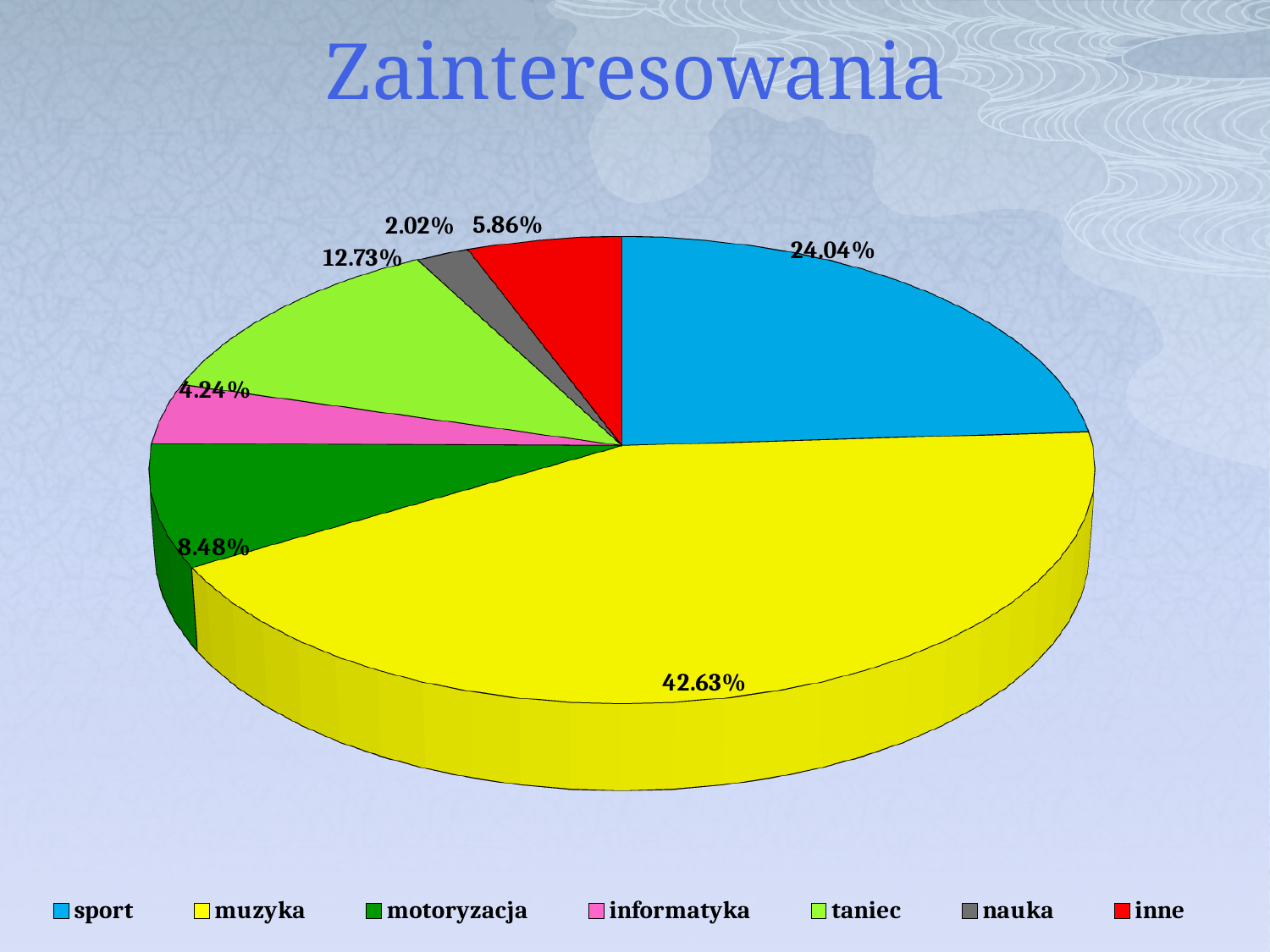
What is the title of the chart? Zainteresowania Which is larger, the share of motoryzacja or the share of informatyka? motoryzacja How many categories does the pie chart show? 7 What share of the pie does taniec have? 12.73% What share of the pie does muzyka have? 42.63% What is the difference between the shares of muzyka and sport? 18.59% What share of the pie does sport have? 24.04% What kind of chart is shown on the slide? pie chart Which category has the largest slice of the pie? muzyka What share of the pie does nauka have? 2.02% Which category has the smallest slice of the pie? nauka What colour is the slice for inne? red